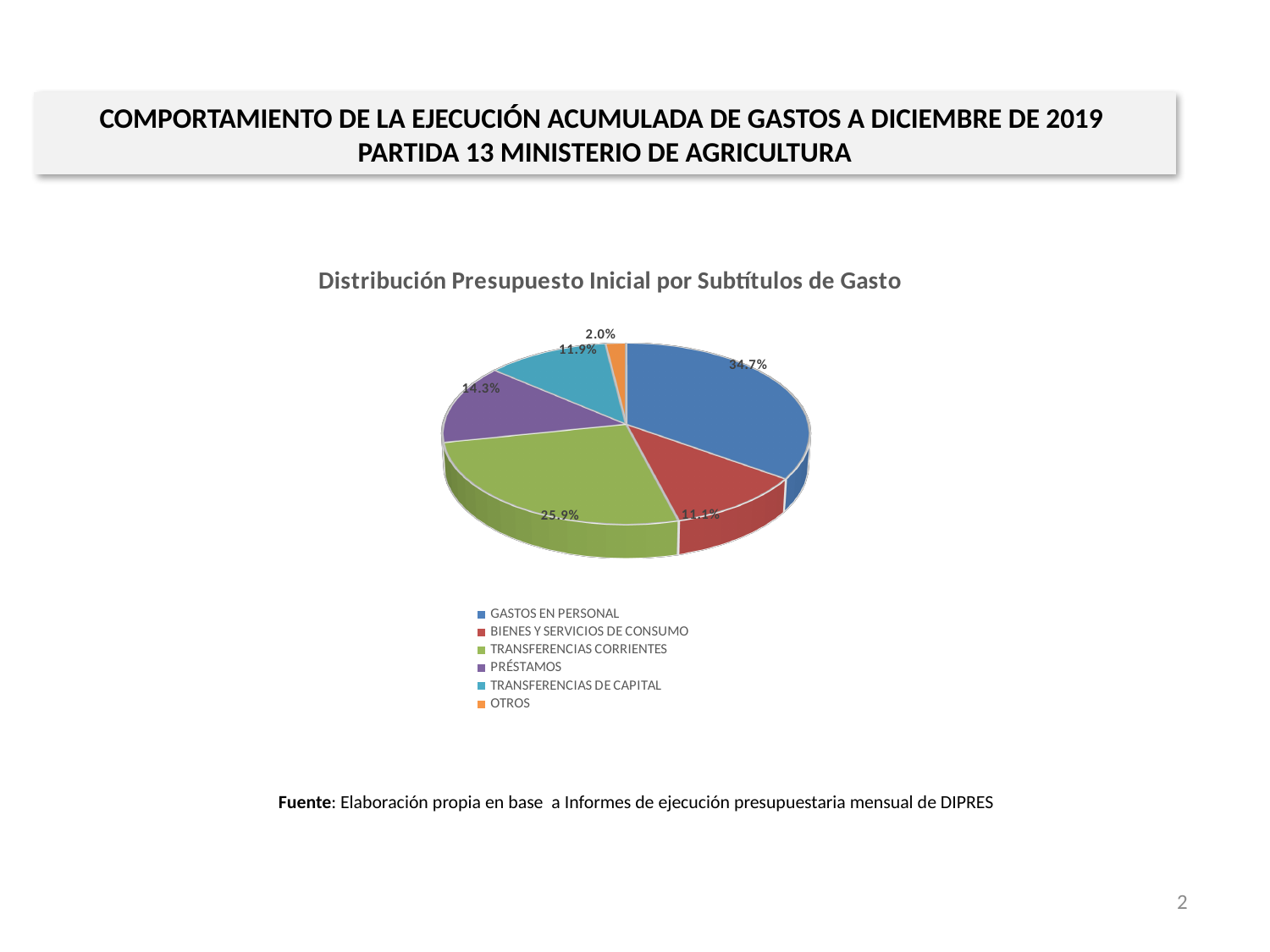
What share of the pie does TRANSFERENCIAS CORRIENTES represent? 25.9% What type of chart is shown on the slide? Pie chart Which is larger, the share for PRÉSTAMOS or the share for BIENES Y SERVICIOS DE CONSUMO? PRÉSTAMOS What is the title of the chart? Distribución Presupuesto Inicial por Subtítulos de Gasto What colour is the slice for TRANSFERENCIAS DE CAPITAL? Teal What is the difference in percentage points between GASTOS EN PERSONAL and TRANSFERENCIAS CORRIENTES? 8.8 What share of the pie does PRÉSTAMOS represent? 14.3% Which category has the smallest slice of the pie? OTROS What share of the pie does GASTOS EN PERSONAL represent? 34.7% Which category has the largest slice of the pie? GASTOS EN PERSONAL How many categories does the pie chart have? 6